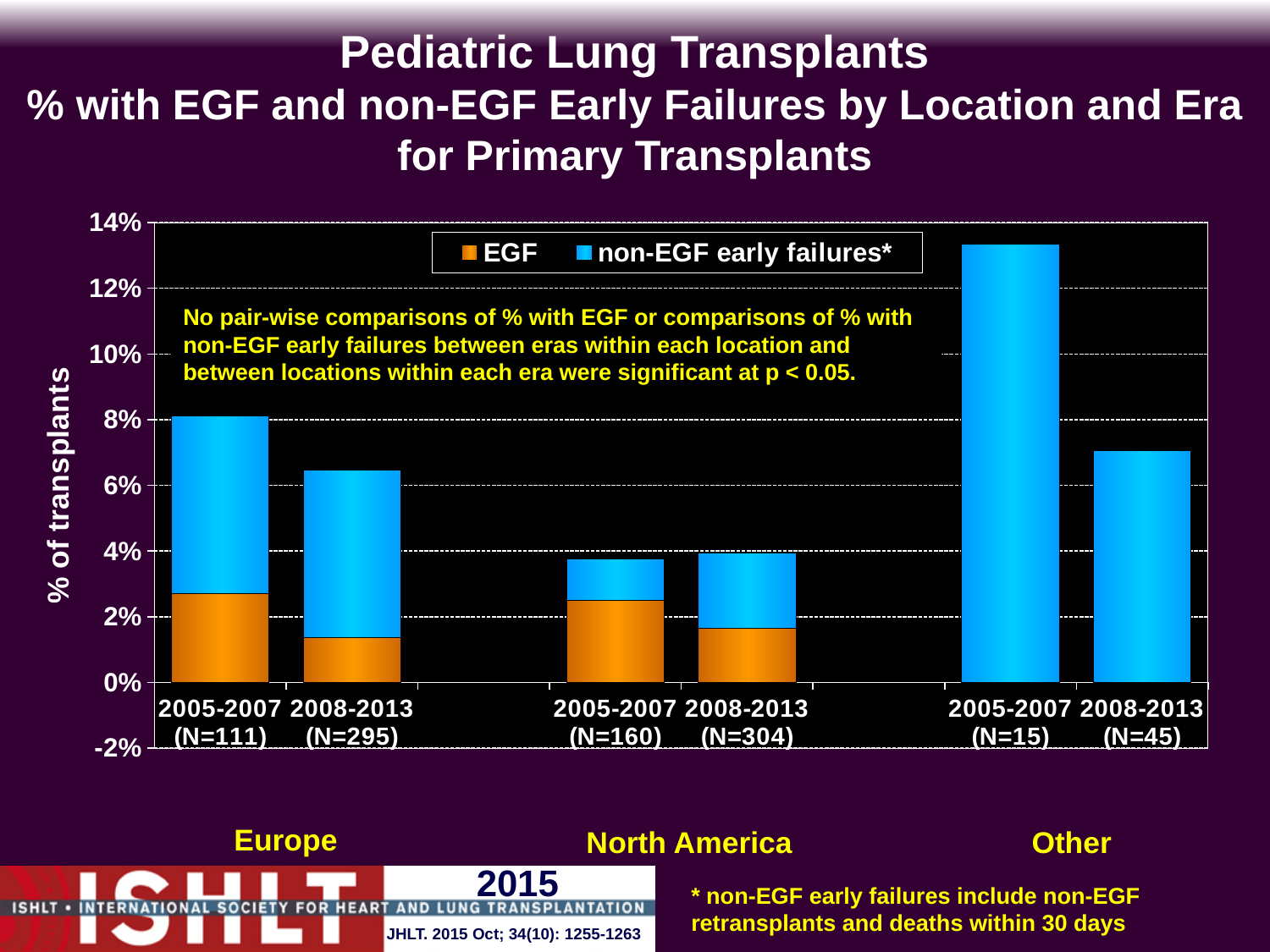
Is the total value for North America 2005-2007 (N=160) greater or less than 6%? less Which has the larger total % of transplants: Europe 2005-2007 or Europe 2008-2013? Europe 2005-2007 Is the total value for Other 2008-2013 (N=45) greater or less than 6%? greater Which bar has the highest total % of transplants? Other 2005-2007 (N=15) Is the total value for Europe 2008-2013 (N=295) greater or less than 8%? less What kind of chart is shown on the slide? bar chart Which location shows no EGF segment in either era? Other What are the two legend entries in the chart? EGF and non-EGF early failures* How many bars are plotted in the chart? 6 How many series does the legend list? 2 Which has the larger total % of transplants: Other 2005-2007 or Other 2008-2013? Other 2005-2007